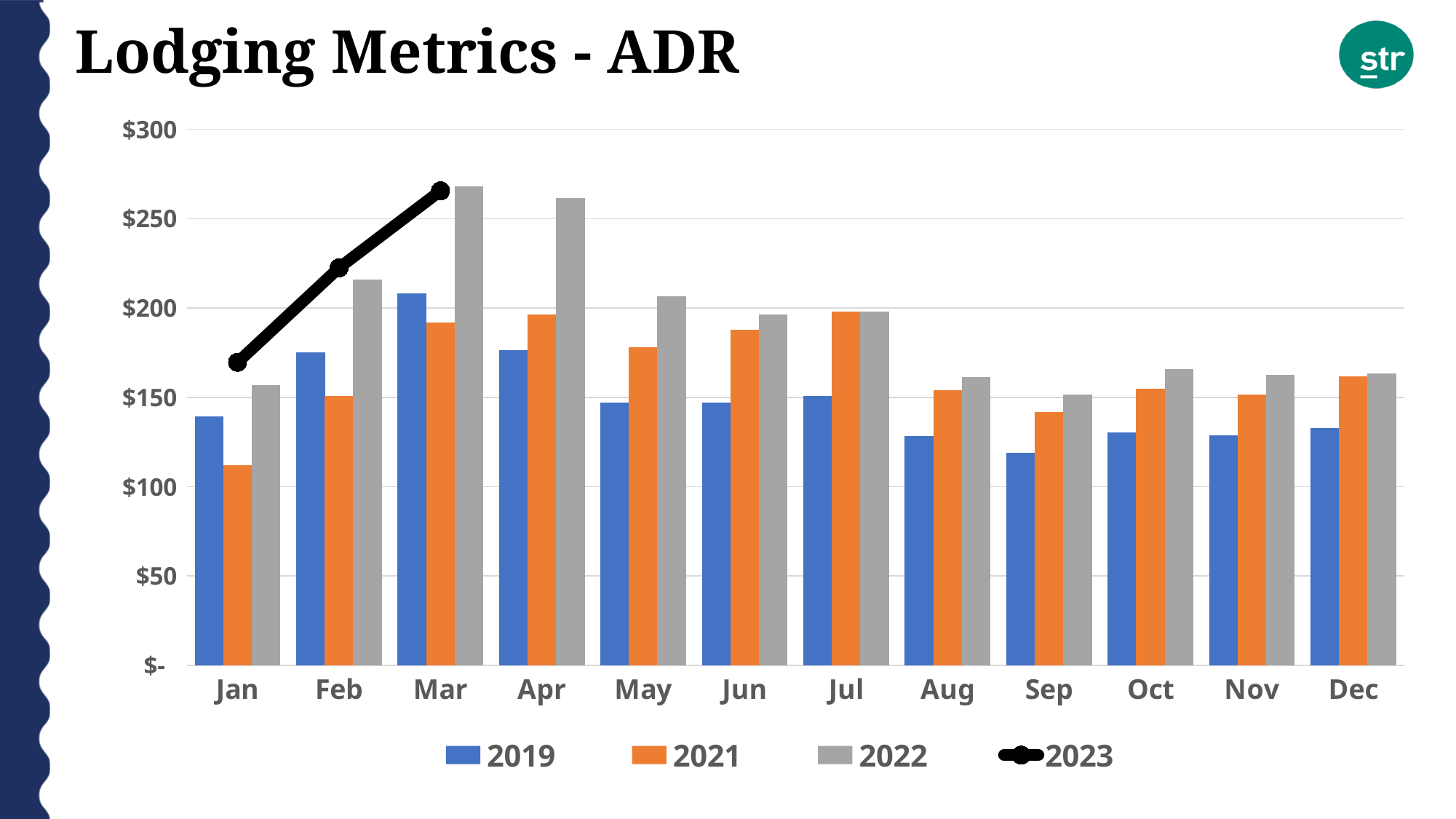
In which month is the 2022 value highest? Mar How many months are shown on the x axis? 12 Is the 2022 value for Mar greater or less than $250? greater Is the 2021 value for Jan greater or less than $150? less What kind of chart is shown on the slide? combination bar and line chart In which month is the 2019 value lowest? Sep How many series does the legend list? 4 In Jan, which is larger: the 2019 value or the 2021 value? 2019 In which month is the 2019 value highest? Mar Is the 2022 value for Feb greater or less than $200? greater In which month is the 2021 value lowest? Jan Does the 2023 line rise or fall from Jan to Mar? rises